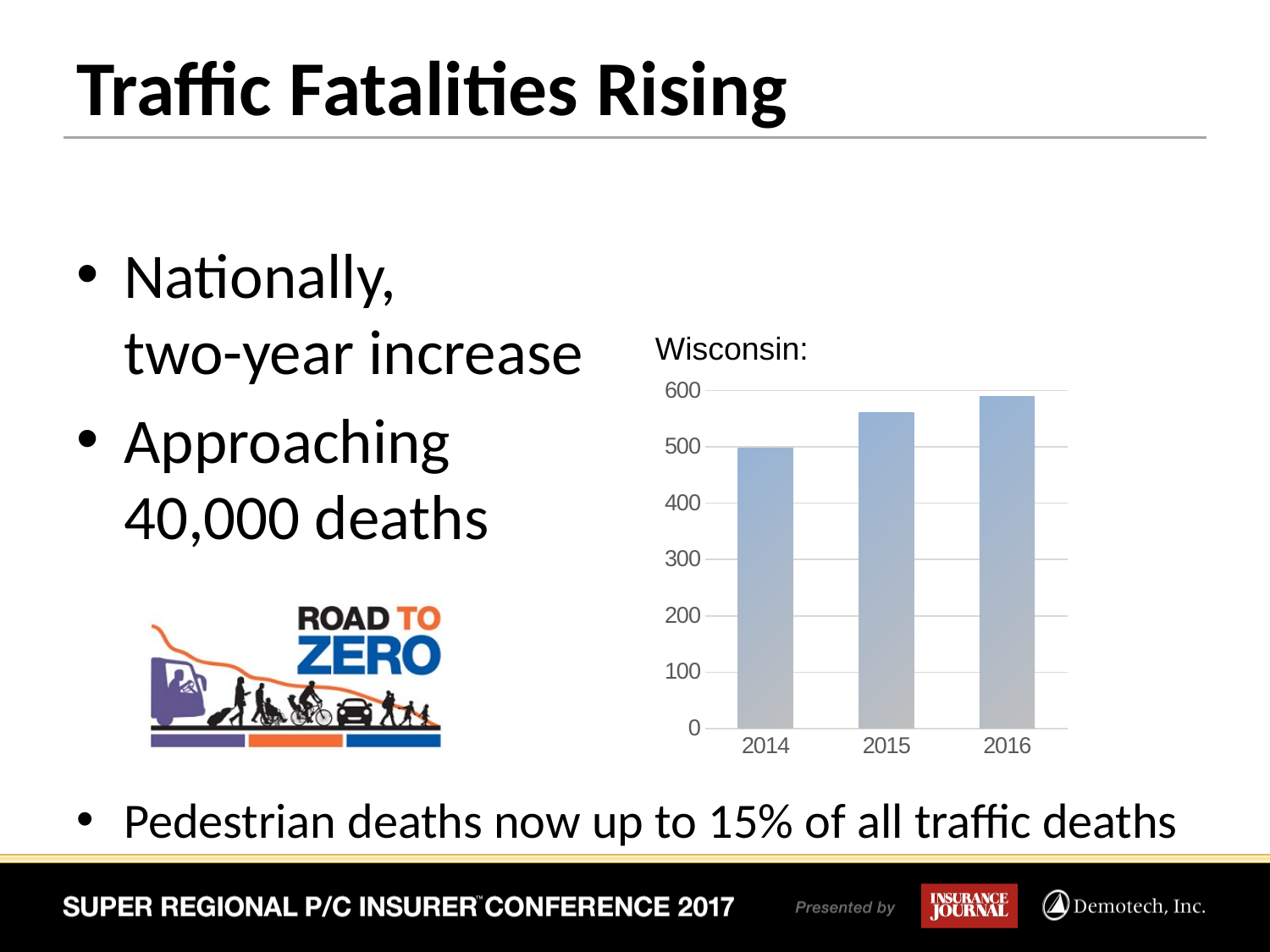
Do the values in the chart rise or fall from 2014 to 2016? rise Which year has the lowest bar in the chart? 2014 Which year has the highest bar in the chart? 2016 Is the value for 2016 greater or less than 500? greater Is the value for 2015 greater or less than 500? greater What kind of chart is shown on the slide? bar chart How many years are shown on the x axis of the chart? 3 What is the highest value labelled on the chart's vertical axis? 600 Is the value for 2014 greater or less than 400? greater Which is larger, the value for 2015 or the value for 2014? 2015 What is the title shown above the chart? Wisconsin: